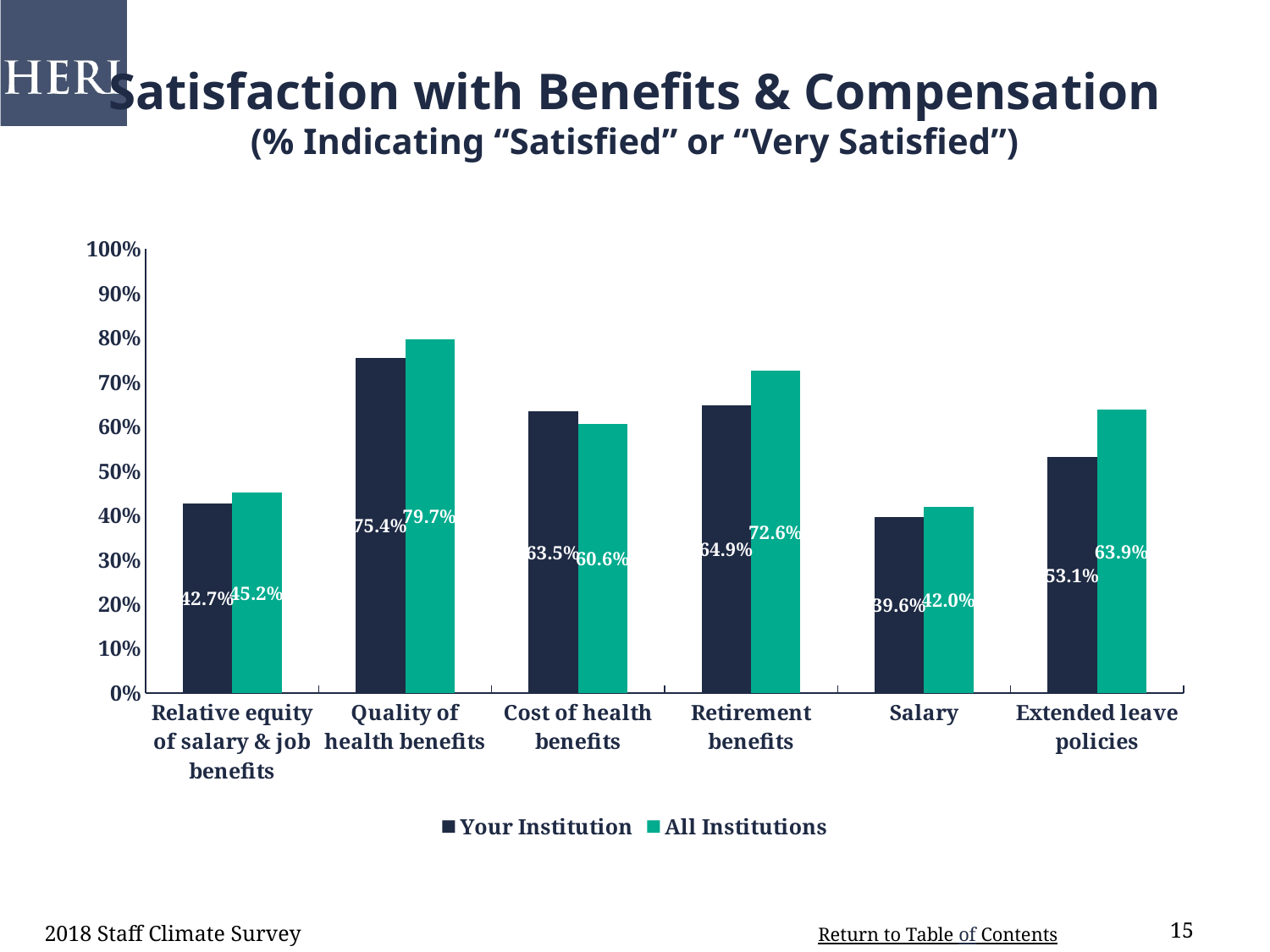
Which category has the lowest value for Your Institution? Salary What is the value for Your Institution for Quality of health benefits? 75.4% What kind of chart is shown on the slide? bar chart What is the title of the chart? Satisfaction with Benefits & Compensation Is the value for All Institutions for Relative equity of salary & job benefits greater or less than 50%? less How many categories are shown on the x axis? 6 What is the value for Your Institution for Salary? 39.6% How many series does the legend list? 2 What is the difference between All Institutions and Your Institution for Retirement benefits? 7.7% Which category has the highest value for All Institutions? Quality of health benefits For Cost of health benefits, which is larger: Your Institution or All Institutions? Your Institution What is the value for All Institutions for Extended leave policies? 63.9%